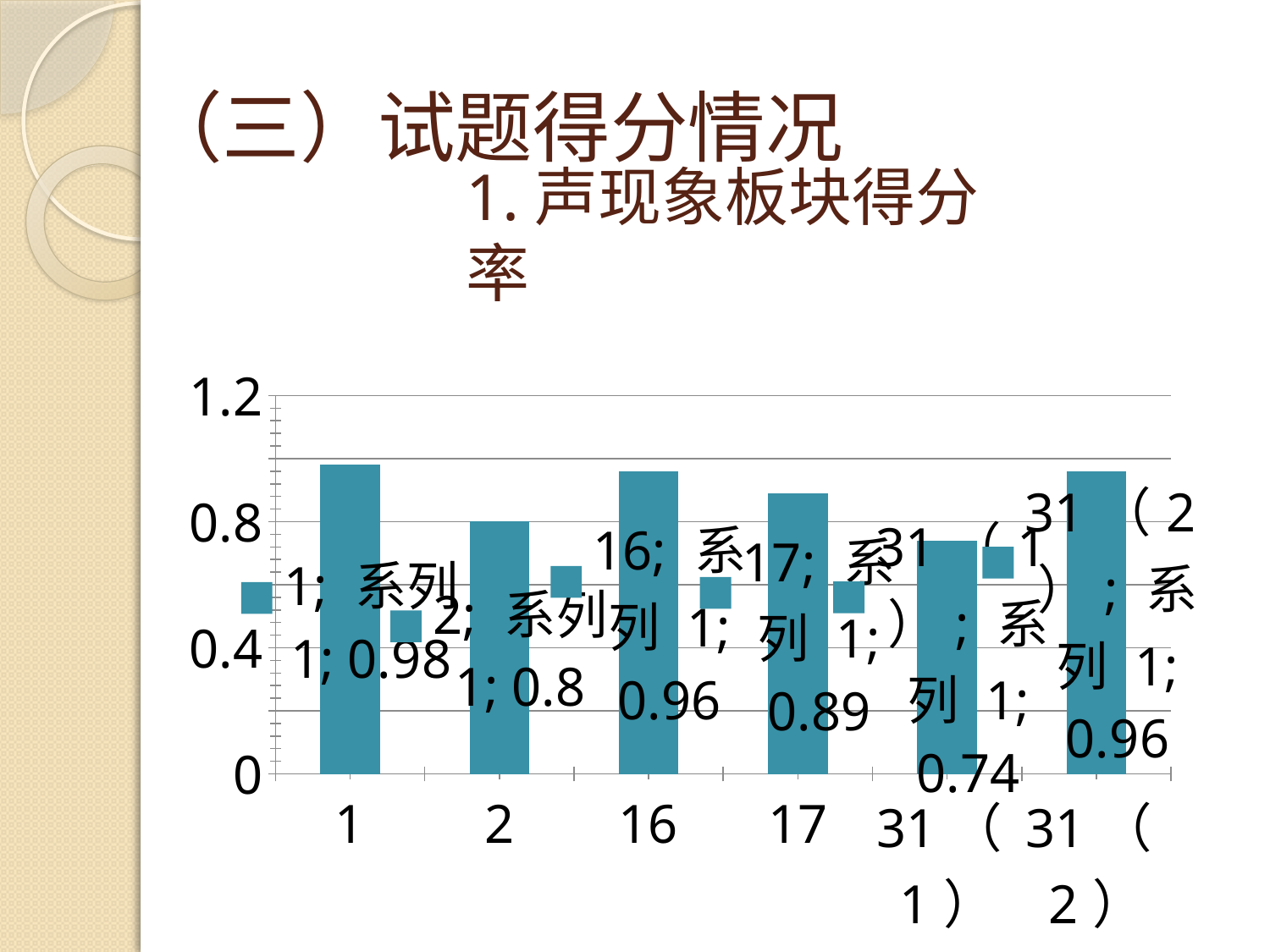
Which category has the lowest value? 31（1） What kind of chart is shown on the slide? bar chart What is the value for category 17? 0.89 What is the value for category 1? 0.98 Which category has the highest value? 1 Which is larger, the value for category 16 or the value for category 17? 16 What is the difference between the values for category 1 and category 2? 0.18 What is the value for category 31（1）? 0.74 Is the value for category 31（1） greater or less than 0.8? less What is the value for category 2? 0.8 How many categories are shown on the x axis? 6 What is the title of the chart? 1. 声现象板块得分率